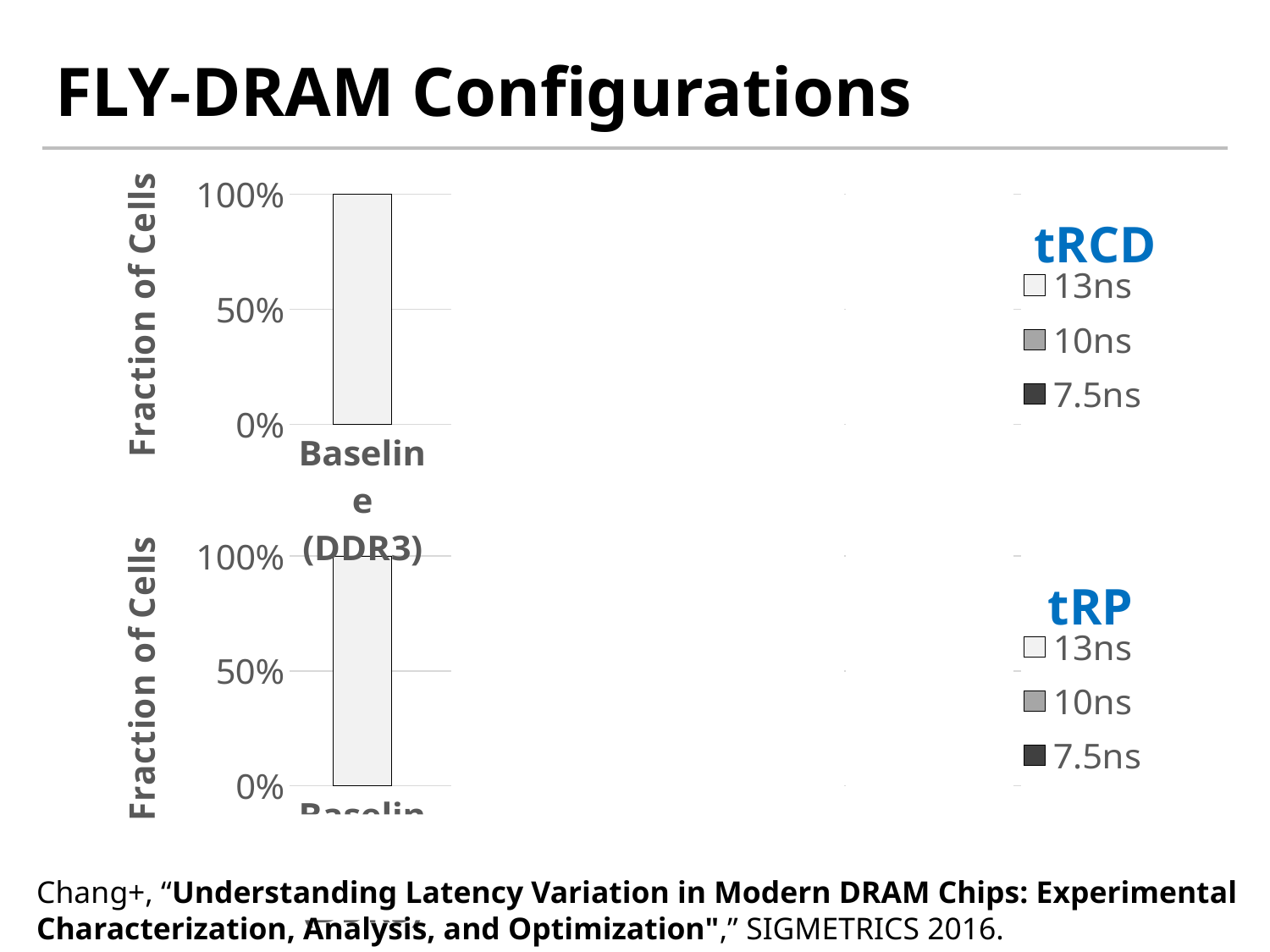
In the bottom chart (tRP), what Fraction of Cells does the single plotted bar reach? 100% How many bars are plotted in the bottom chart (tRP)? 1 In the top chart (tRCD), is the value for Baseline (DDR3) greater or less than 50%? greater In the top chart (tRCD), what is the Fraction of Cells for Baseline (DDR3)? 100% In the bottom chart (tRP), is the value of the plotted bar greater or less than 50%? greater How many series does the legend of the bottom chart (tRP) list? 3 What is the y-axis label of the top chart (tRCD)? Fraction of Cells What are the three legend entries of the bottom chart (tRP)? 13ns, 10ns, 7.5ns What kind of chart is the top chart (tRCD)? bar chart What kind of chart is the bottom chart (tRP)? bar chart How many categories are plotted on the x axis of the top chart (tRCD)? 1 How many series does the legend of the top chart (tRCD) list? 3